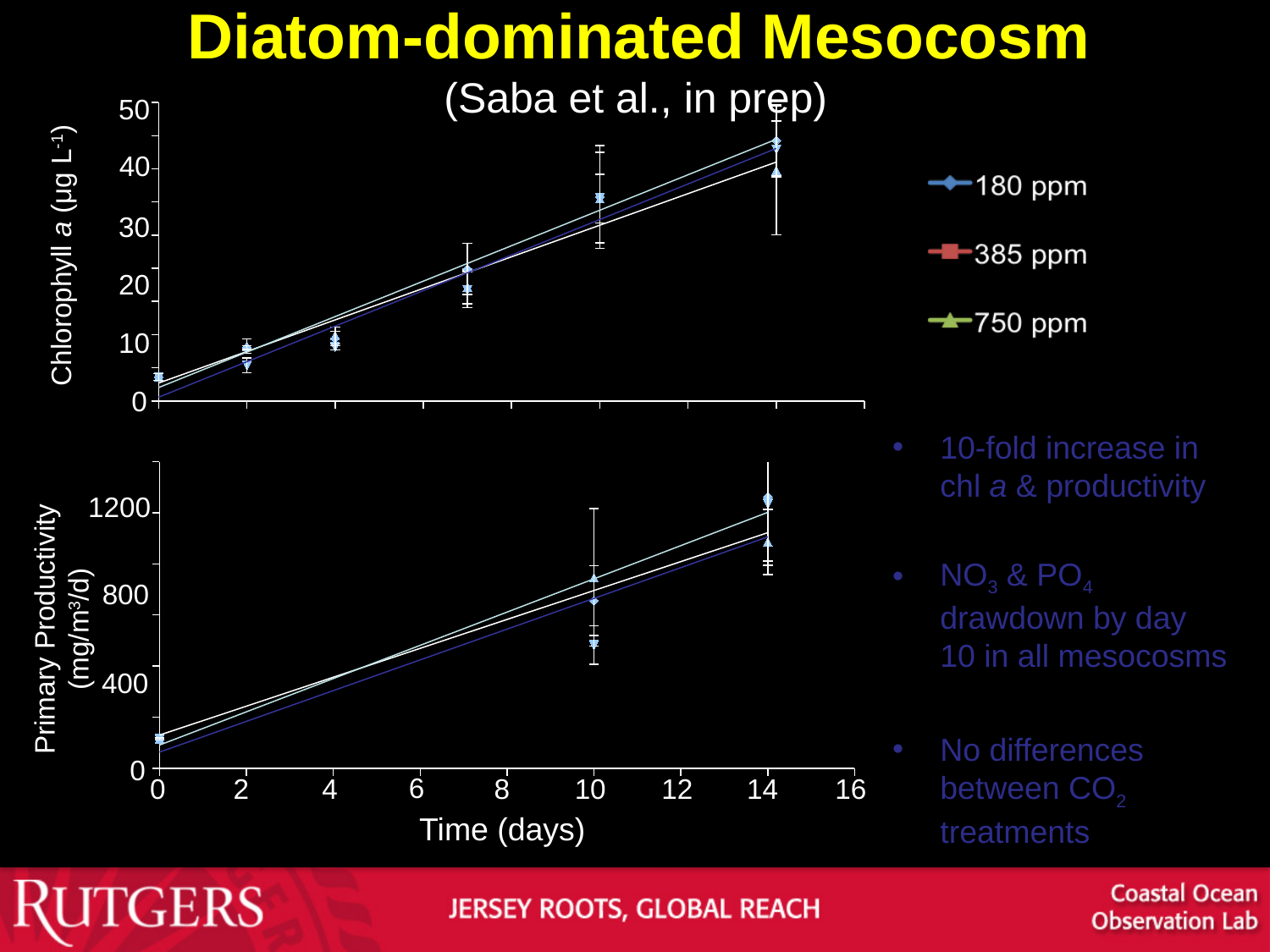
How many series does the legend list? 3 In the top chart (Chlorophyll a), is the value for 180 ppm at day 0 greater or less than 10? less In the top chart (Chlorophyll a), is the value for 180 ppm at day 14 greater or less than 30? greater In the top chart (Chlorophyll a), do the values rise or fall as time increases? rise How many time points are plotted for each series in the bottom chart (Primary Productivity)? 3 In the bottom chart (Primary Productivity), is the value for 750 ppm at day 0 greater or less than 400? less In the bottom chart (Primary Productivity), do the values rise or fall as time increases? rise What is the label of the x axis shared by both charts? Time (days) What is the highest tick value shown on the y axis of the top chart (Chlorophyll a)? 50 What kind of chart is the top chart (Chlorophyll a vs Time)? line chart